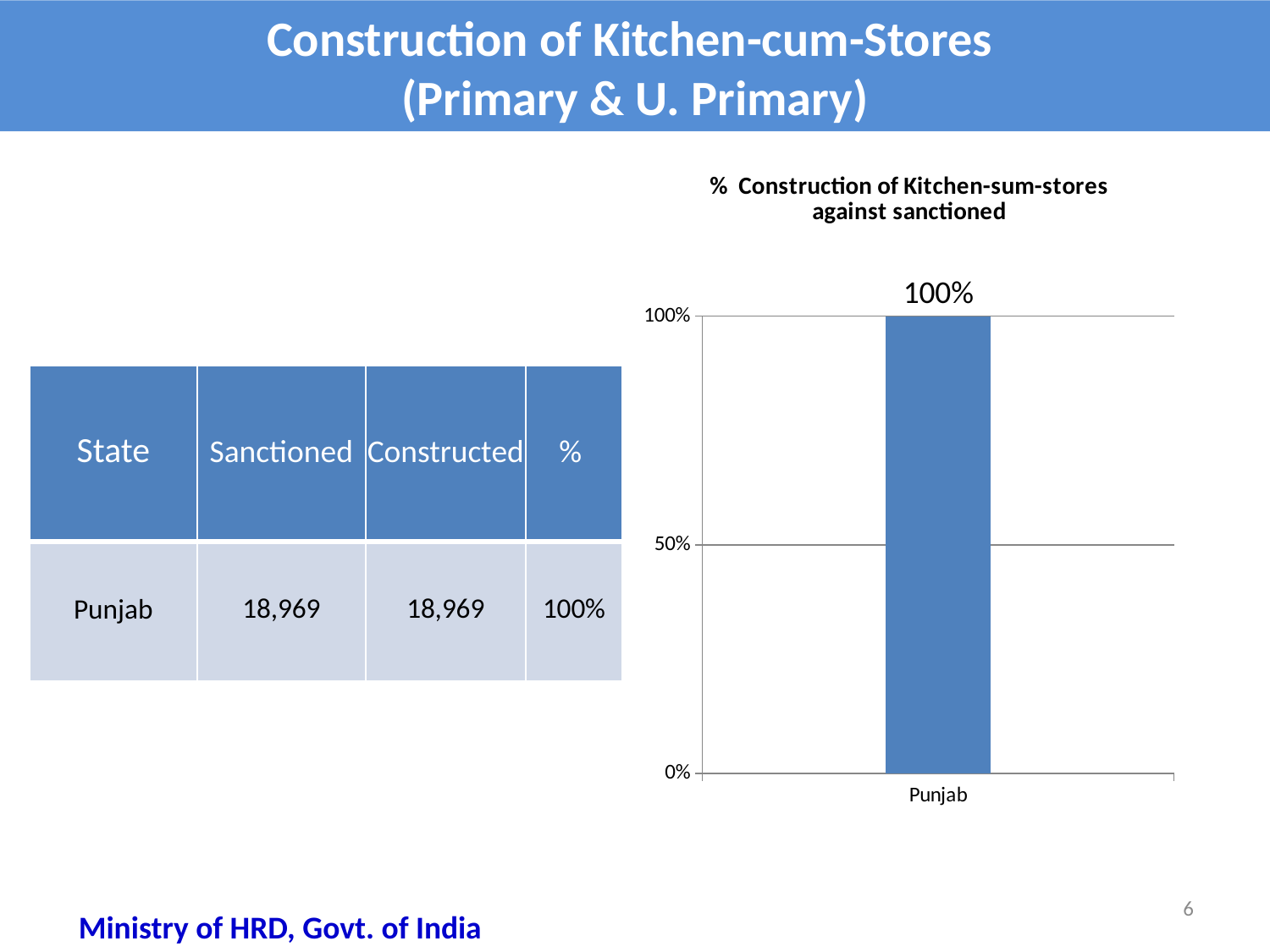
What kind of chart is shown on the slide? bar chart Is the value for Punjab greater or less than 50%? greater What is the value for Punjab in the chart? 100% What is the highest value shown on the chart's y axis? 100% Which category is shown on the x axis of the chart? Punjab What is the title of the chart? % Construction of Kitchen-sum-stores against sanctioned How many categories are plotted in the chart? 1